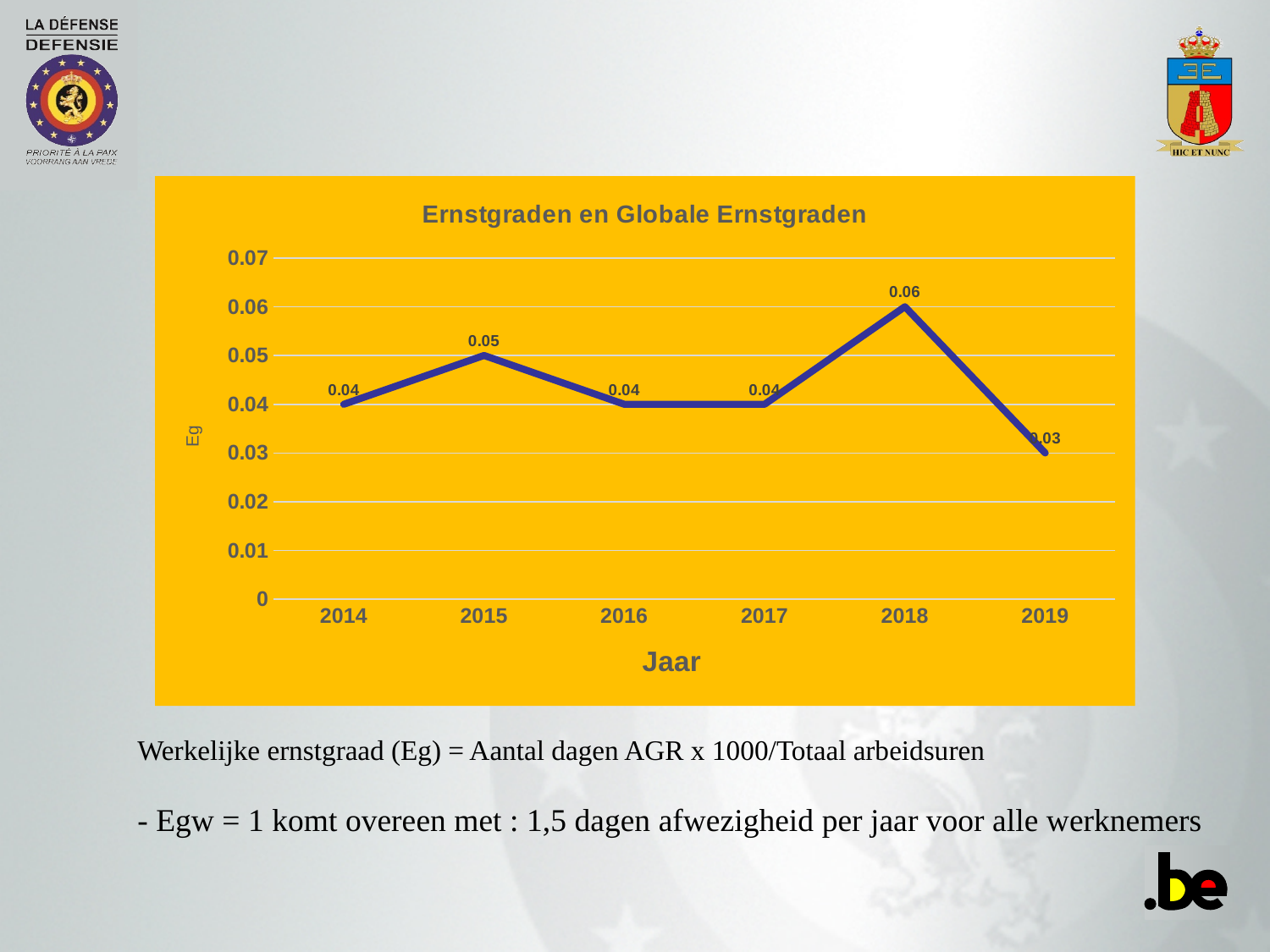
What kind of chart is shown? line chart Is the value for 2018 greater or less than 0.05? greater Which year has the lowest value? 2019 Which is larger, the value for 2015 or the value for 2016? 2015 How many years are plotted on the x axis? 6 What is the value for 2014? 0.04 Which year has the highest value? 2018 What is the title of the chart? Ernstgraden en Globale Ernstgraden What is the value for 2015? 0.05 What is the value for 2019? 0.03 What is the difference between the values for 2018 and 2019? 0.03 What is the value for 2018? 0.06